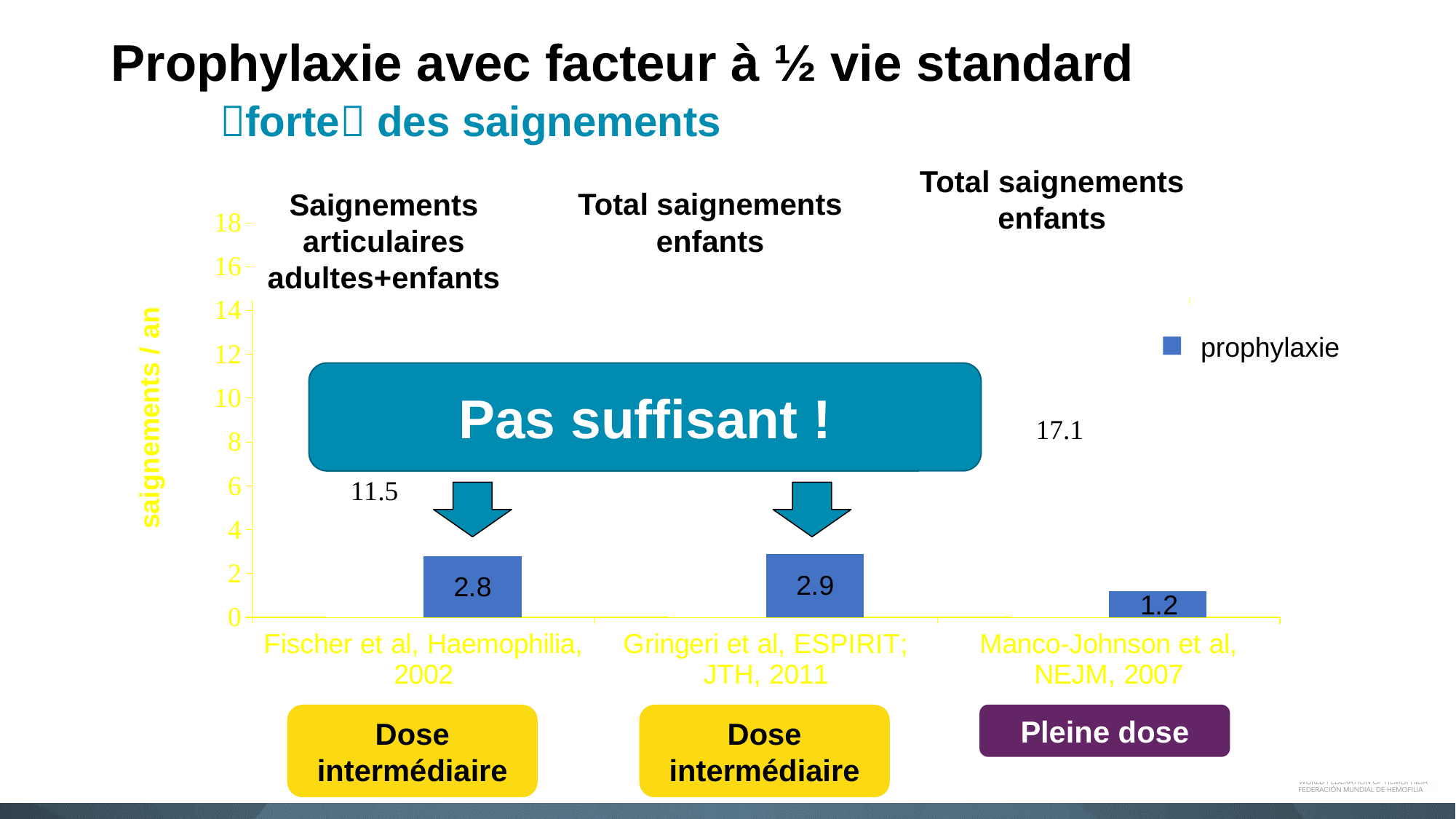
What is the prophylaxie value for Fischer et al, Haemophilia, 2002? 2.8 What is the label of the y axis of the chart? saignements / an What series name is shown in the chart legend? prophylaxie Which study has the highest prophylaxie bar? Gringeri et al, ESPIRIT; JTH, 2011 Which study has the lowest prophylaxie bar? Manco-Johnson et al, NEJM, 2007 What is the prophylaxie value for Gringeri et al, ESPIRIT; JTH, 2011? 2.9 What is the prophylaxie value for Manco-Johnson et al, NEJM, 2007? 1.2 Which is larger, the prophylaxie value for Fischer et al, Haemophilia, 2002 or for Manco-Johnson et al, NEJM, 2007? Fischer et al, Haemophilia, 2002 What kind of chart is shown on the slide? bar chart What is the difference between the prophylaxie values for Gringeri et al, ESPIRIT; JTH, 2011 and Manco-Johnson et al, NEJM, 2007? 1.7 Is the prophylaxie value for Manco-Johnson et al, NEJM, 2007 greater or less than 2? less How many studies are shown on the x axis of the chart? 3